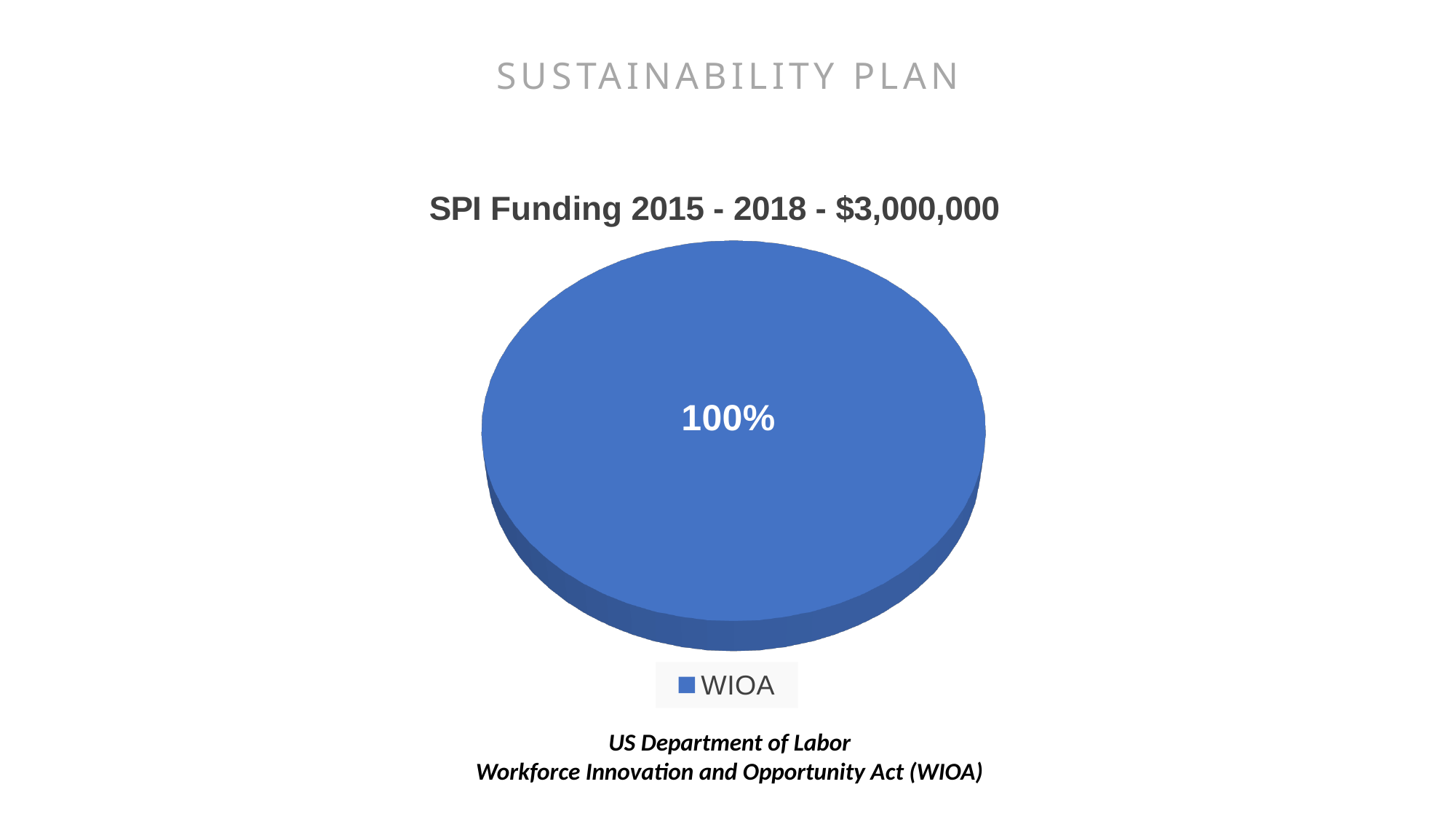
How many entries does the legend list? 1 What share of the pie does WIOA represent? 100% How many slices does the pie chart have? 1 What is the title of the chart? SPI Funding 2015 - 2018 - $3,000,000 What kind of chart is shown on the slide? pie chart What is the data label printed on the pie slice? 100% What is the label of the only category in the legend? WIOA Which category accounts for the largest share of the pie? WIOA